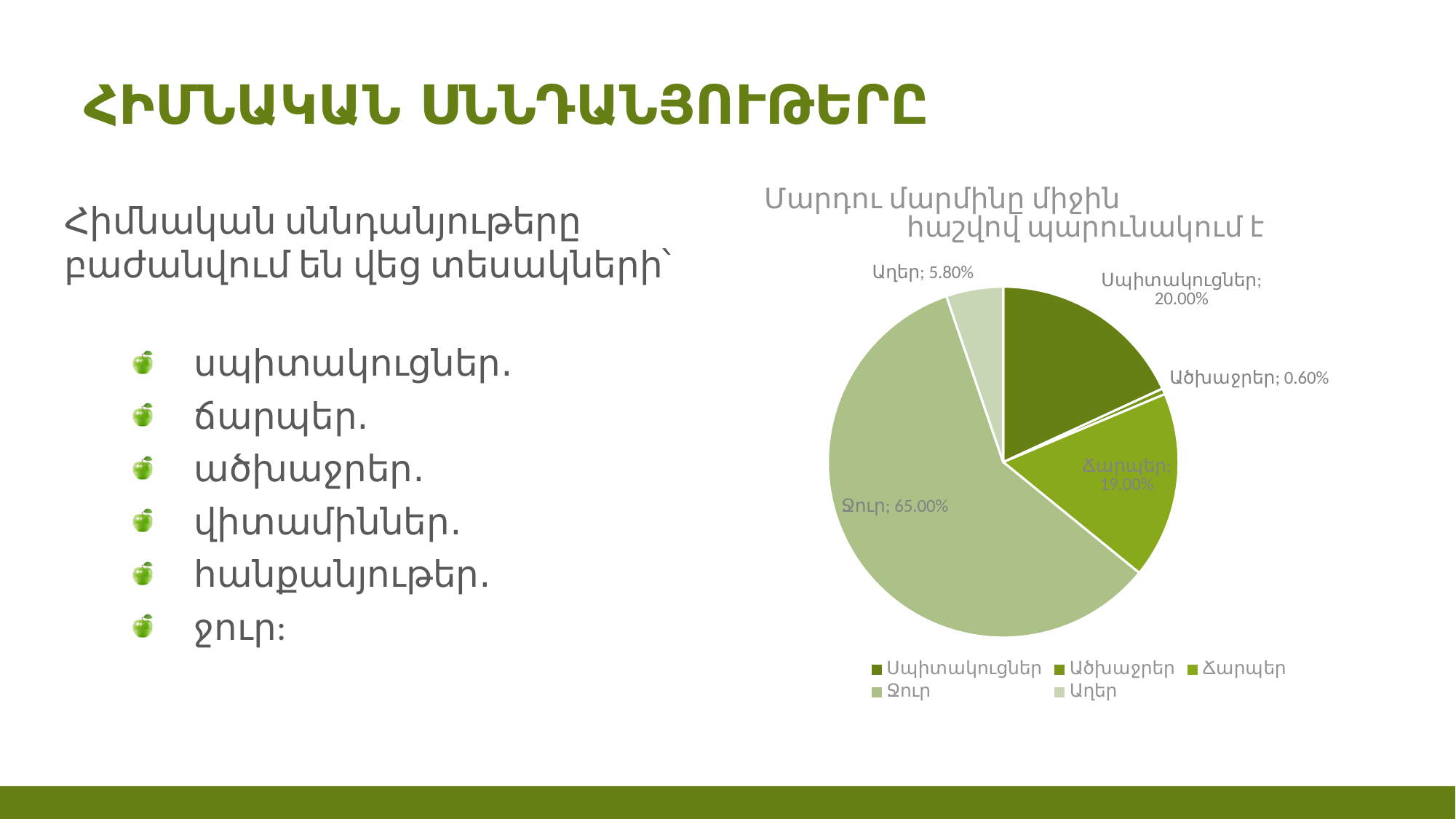
What is the value for Աղեր in the pie chart? 5.80% What is the value for Սպիտակուցներ in the pie chart? 20.00% What is the title of the pie chart? Մարդու մարմինը միջին հաշվով պարունակում է What is the value for Ջուր in the pie chart? 65.00% How many slices does the pie chart have? 5 Which slice of the pie chart is the smallest? Ածխաջրեր What is the value for Ճարպեր in the pie chart? 19.00% Which slice of the pie chart is the largest? Ջուր What type of chart is shown on the slide? Pie chart What is the value for Ածխաջրեր in the pie chart? 0.60% What is the difference between the values for Ջուր and Սպիտակուցներ? 45.00% Which is larger, the value for Աղեր or the value for Ածխաջրեր? Աղեր